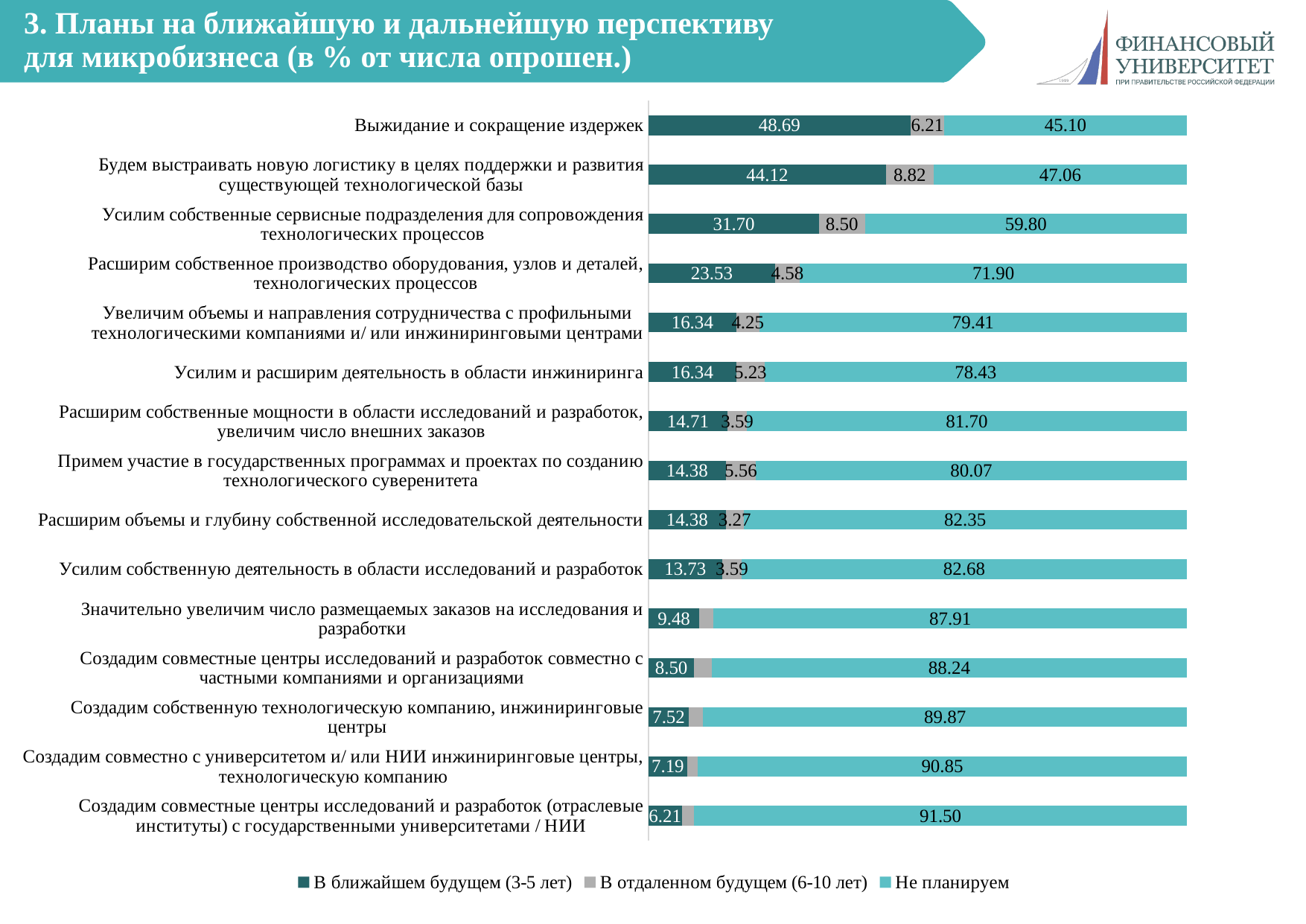
Which is larger: the "Не планируем" value for "Расширим собственное производство оборудования, узлов и деталей, технологических процессов" or for "Усилим и расширим деятельность в области инжиниринга"? Усилим и расширим деятельность в области инжиниринга Which category has the lowest value for "В ближайшем будущем (3-5 лет)"? Создадим совместные центры исследований и разработок (отраслевые институты) с государственными университетами / НИИ Which category has the highest value for "Не планируем"? Создадим совместные центры исследований и разработок (отраслевые институты) с государственными университетами / НИИ How many categories (plans) are plotted on the chart? 15 What is the value of "Не планируем" for "Усилим собственные сервисные подразделения для сопровождения технологических процессов"? 59.80 What is the total of the stacked bar for "Выжидание и сокращение издержек"? 100.00 What is the value of "В отдаленном будущем (6-10 лет)" for "Будем выстраивать новую логистику в целях поддержки и развития существующей технологической базы"? 8.82 What kind of chart is shown on the slide? Stacked horizontal bar chart What is the value of "В ближайшем будущем (3-5 лет)" for "Выжидание и сокращение издержек"? 48.69 How many series does the legend list? 3 Which legend entry is shown in the lightest (turquoise) colour? Не планируем What is the difference between the "В ближайшем будущем (3-5 лет)" values for "Выжидание и сокращение издержек" and "Будем выстраивать новую логистику в целях поддержки и развития существующей технологической базы"? 4.57